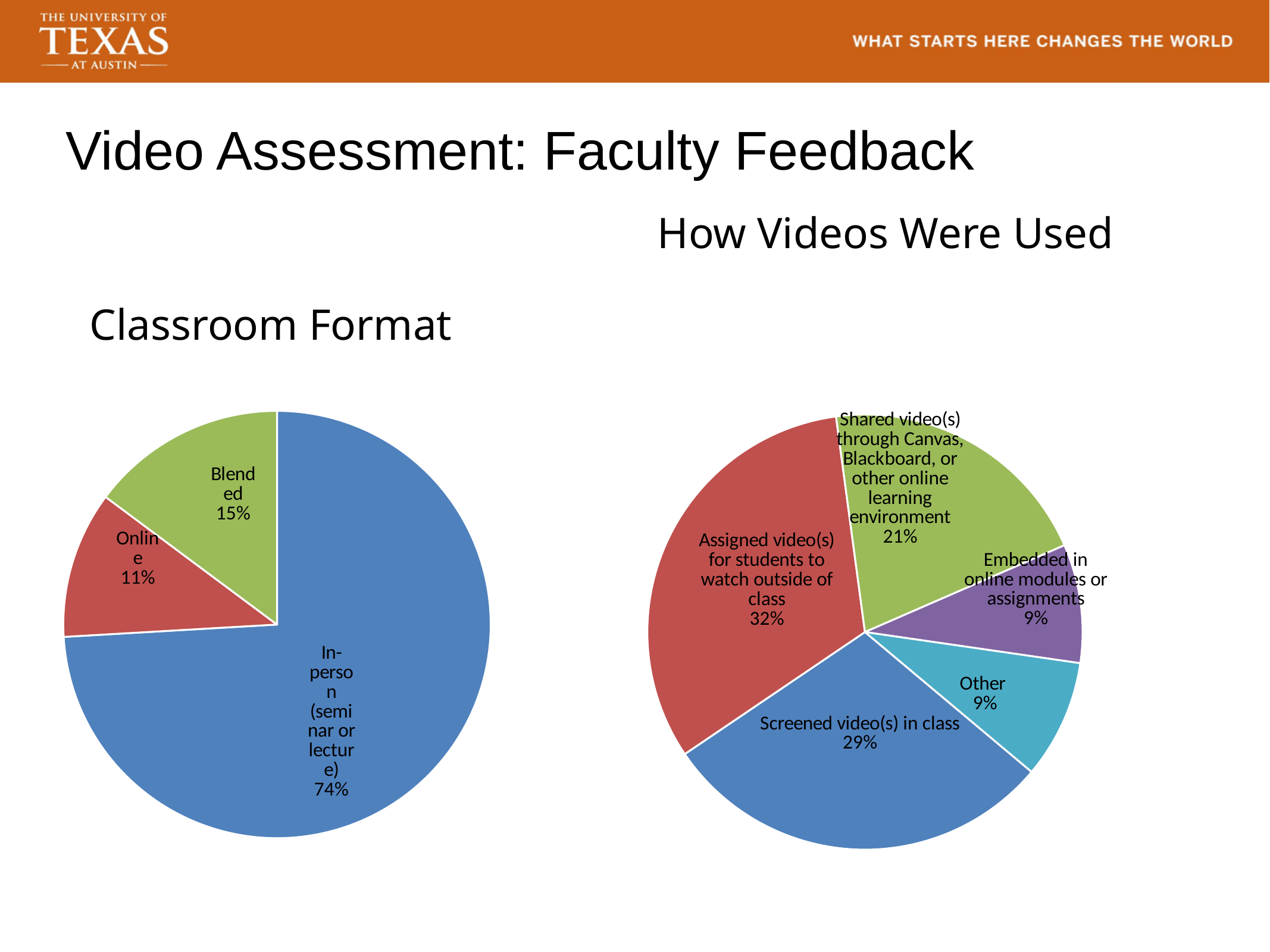
In the How Videos Were Used chart, which category has the largest slice? Assigned video(s) for students to watch outside of class In the Classroom Format chart, what is the difference between Blended and Online? 4% In the How Videos Were Used chart, what colour is the Other slice? Teal In the How Videos Were Used chart, what is the value for Screened video(s) in class? 29% In the Classroom Format chart, what share of the pie is In-person (seminar or lecture)? 74% In the How Videos Were Used chart, what is the difference between Assigned video(s) for students to watch outside of class and Shared video(s) through Canvas, Blackboard, or other online learning environment? 11% What kind of chart is the How Videos Were Used chart? Pie chart In the Classroom Format chart, which category has the smallest slice? Online How many slices does the Classroom Format pie chart have? 3 How many slices does the How Videos Were Used pie chart have? 5 In the Classroom Format chart, what is the value for Online? 11% In the How Videos Were Used chart, which is larger: Screened video(s) in class or Embedded in online modules or assignments? Screened video(s) in class